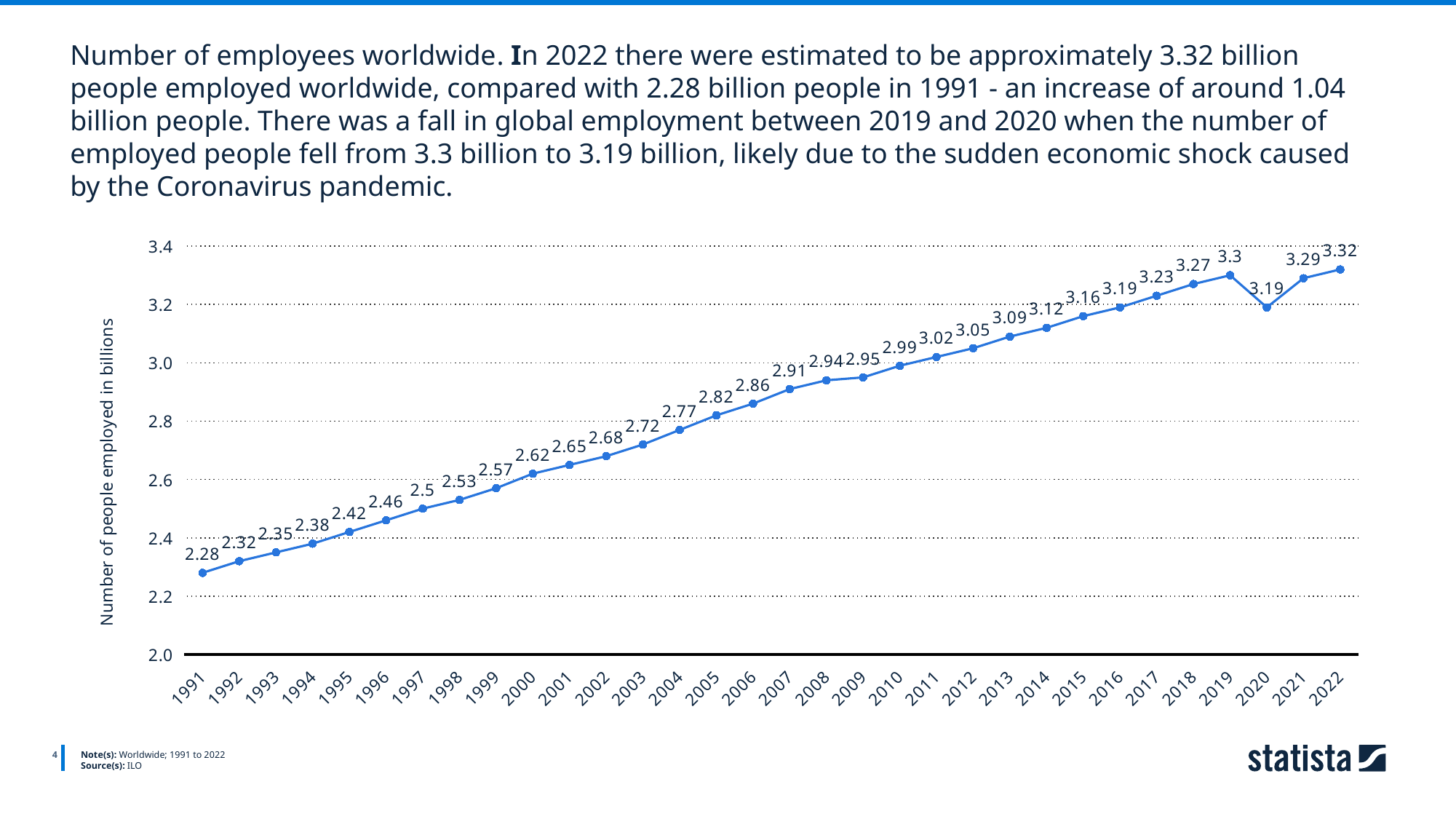
Which year has the highest value on the chart? 2022 Which year has the larger value, 2019 or 2021? 2019 What is the number of people employed worldwide in 2022 according to the chart? 3.32 What value does the chart show for 2020? 3.19 What is the difference between the values for 2019 and 2020? 0.11 What is the label of the y-axis? Number of people employed in billions What value does the chart show for 2005? 2.82 Which year has the lowest value on the chart? 1991 What value does the chart show for 1991? 2.28 Which year has the larger value, 2016 or 2020? They are equal (3.19) What type of chart is shown on the slide? Line chart How many years are plotted on the chart? 32